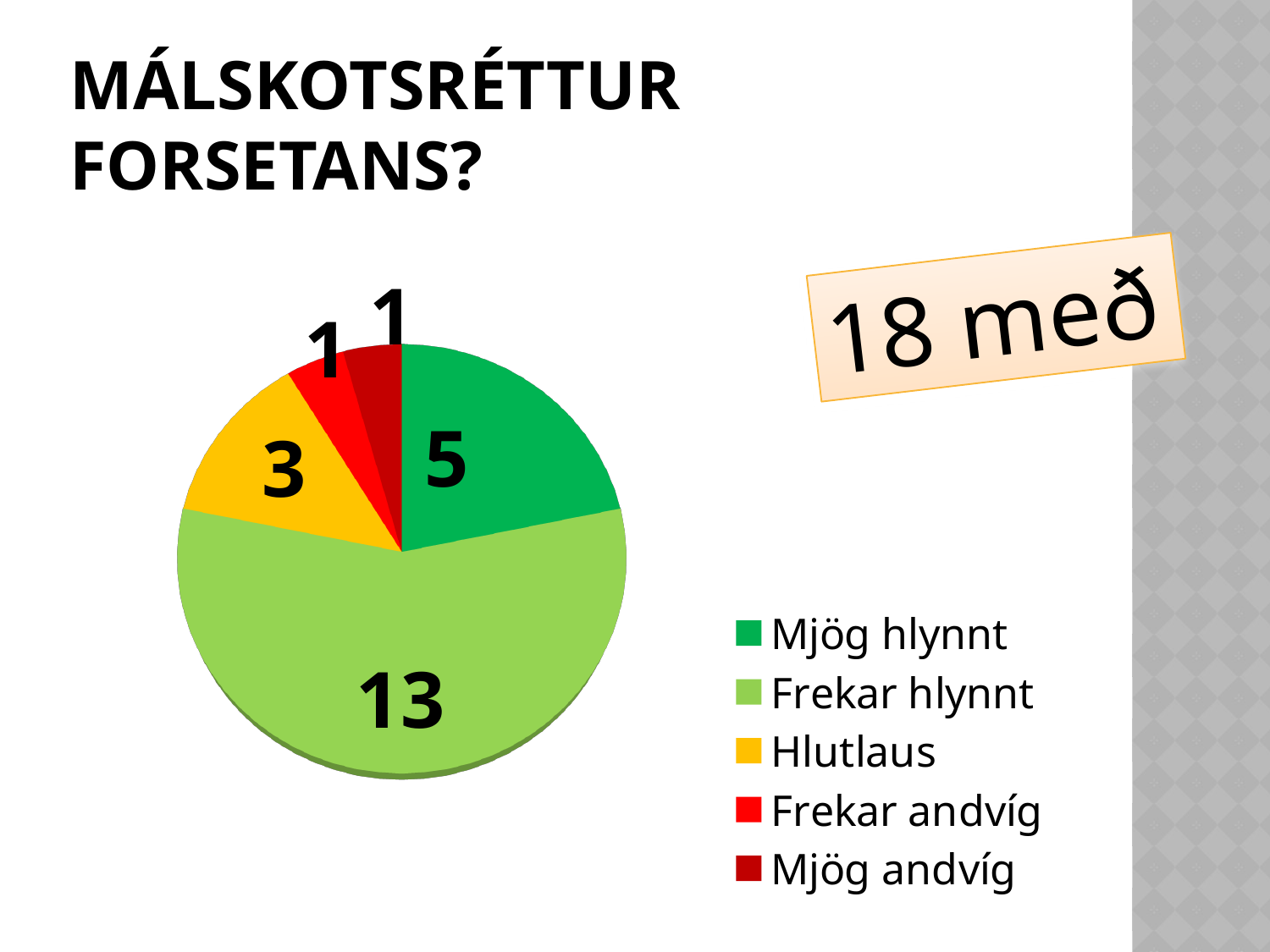
What is the difference between the values for Frekar hlynnt and Mjög hlynnt? 8 What is the total of all the slices in the pie? 23 What kind of chart is shown on the slide? pie chart What is the value for Frekar hlynnt? 13 What is the title of the slide containing the pie chart? MÁLSKOTSRÉTTUR FORSETANS? Which category has the largest slice of the pie? Frekar hlynnt What is the value for Hlutlaus? 3 What colour is the Hlutlaus slice? yellow How many categories does the legend list? 5 Which is larger, the value for Hlutlaus or the value for Mjög hlynnt? Mjög hlynnt What is the value for Mjög hlynnt? 5 What is the value for Frekar andvíg? 1